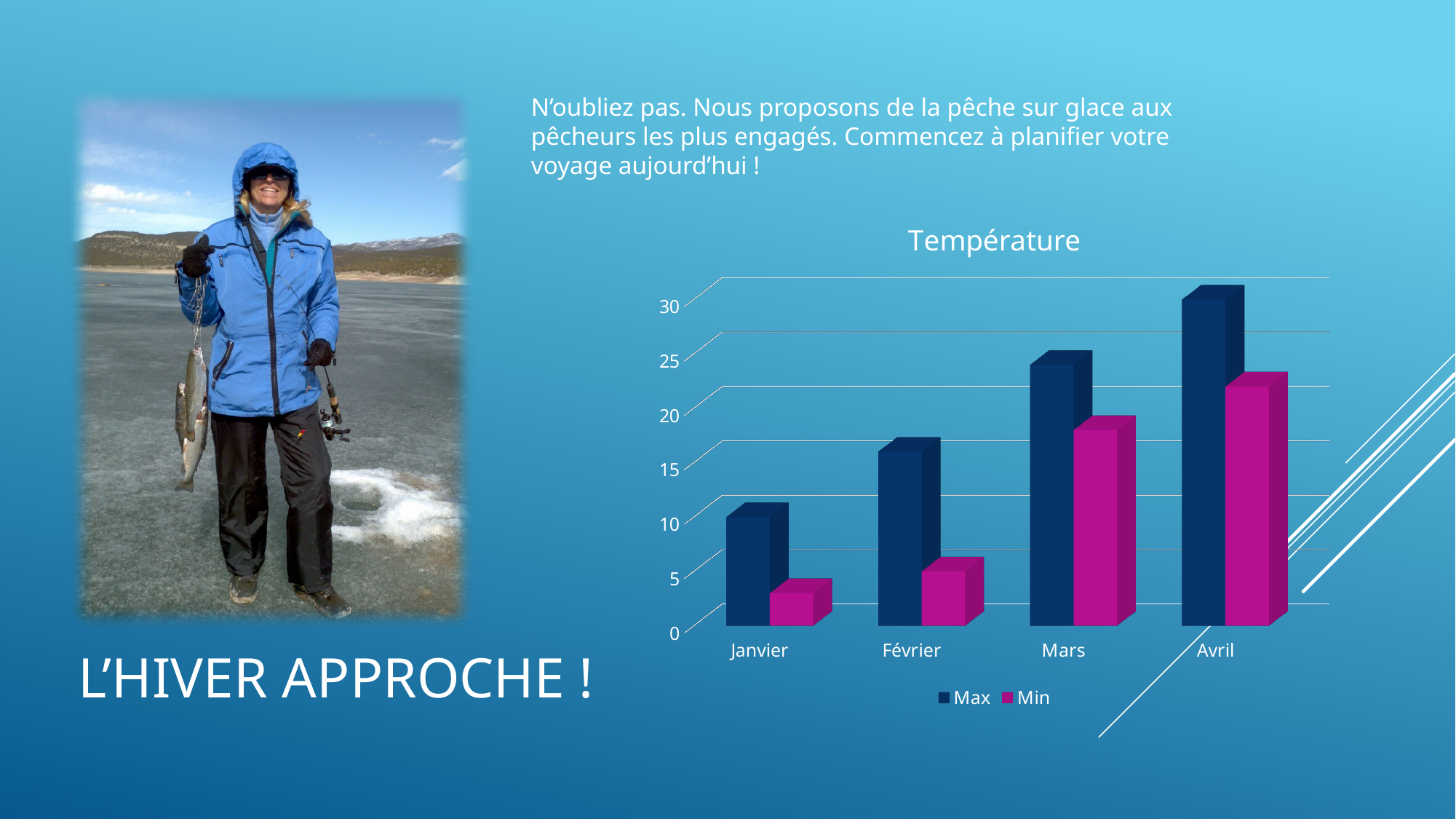
Which is larger, the Max value for Mars or the Max value for Février? Mars Is the Max value for Avril greater or less than 25? greater Is the Max value for Janvier greater or less than 15? less What is the title of the chart? Température Which is larger, the Min value for Avril or the Min value for Mars? Avril What kind of chart is shown on the slide? bar chart Do the Max values rise or fall from Janvier to Avril? rise Is the Min value for Mars greater or less than 10? greater Which month has the lowest Min value? Janvier Which month has the highest Max value? Avril How many months are shown on the x axis of the chart? 4 How many series does the legend list? 2